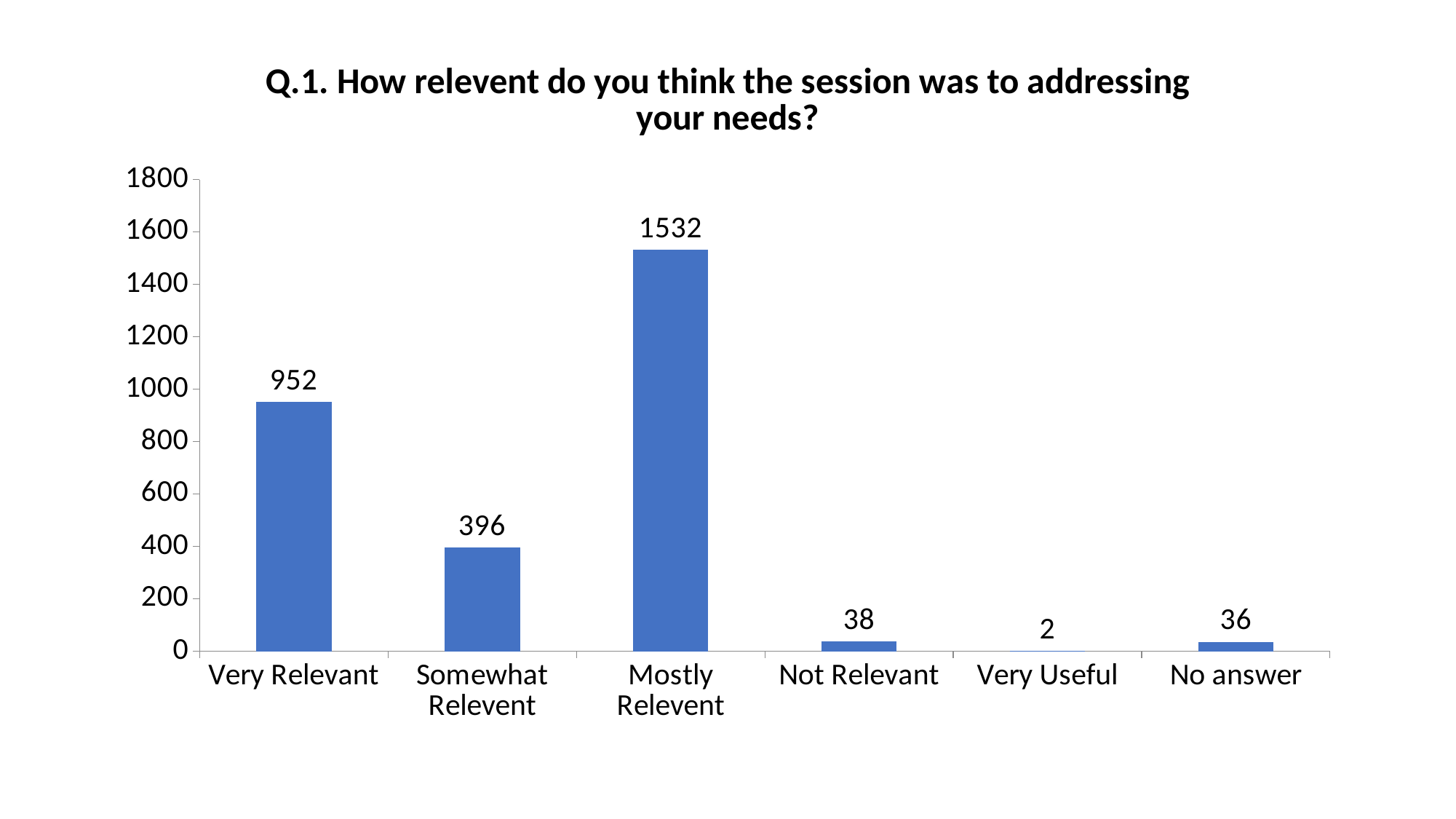
What is the title of the chart? Q.1. How relevent do you think the session was to addressing your needs? What is the difference between the values for Mostly Relevent and Very Relevant? 580 What is the value for Mostly Relevent? 1532 How many categories are shown on the x axis? 6 Which is larger, the value for Very Relevant or the value for Somewhat Relevent? Very Relevant What is the value for Somewhat Relevent? 396 Which category has the highest value? Mostly Relevent What kind of chart is shown on the slide? Bar chart What is the value for No answer? 36 Which category has the lowest value? Very Useful What is the value for Not Relevant? 38 What is the value for Very Relevant? 952